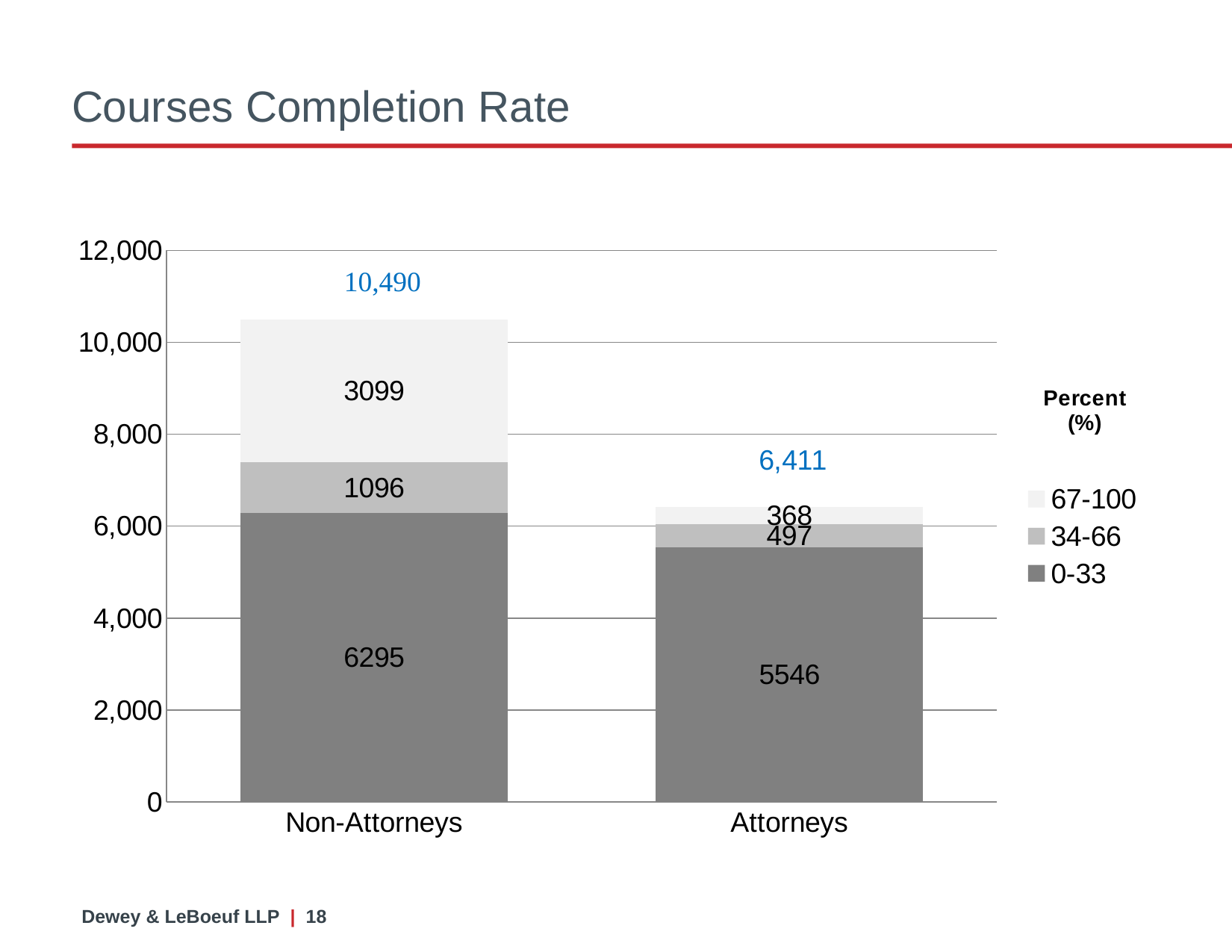
What is the value of the 34-66 segment for Attorneys? 497 How many categories are shown on the x axis? 2 Which category has the higher total, Non-Attorneys or Attorneys? Non-Attorneys What is the value of the 67-100 segment for Attorneys? 368 What type of chart is shown on the slide? Stacked bar chart What is the total of the stacked bar for Attorneys? 6,411 What is the total of the stacked bar for Non-Attorneys? 10,490 What is the difference between the 0-33 values for Non-Attorneys and Attorneys? 749 What is the value of the 34-66 segment for Non-Attorneys? 1096 What is the title of the slide? Courses Completion Rate What is the value of the 0-33 segment for Non-Attorneys? 6295 How many series does the legend list? 3